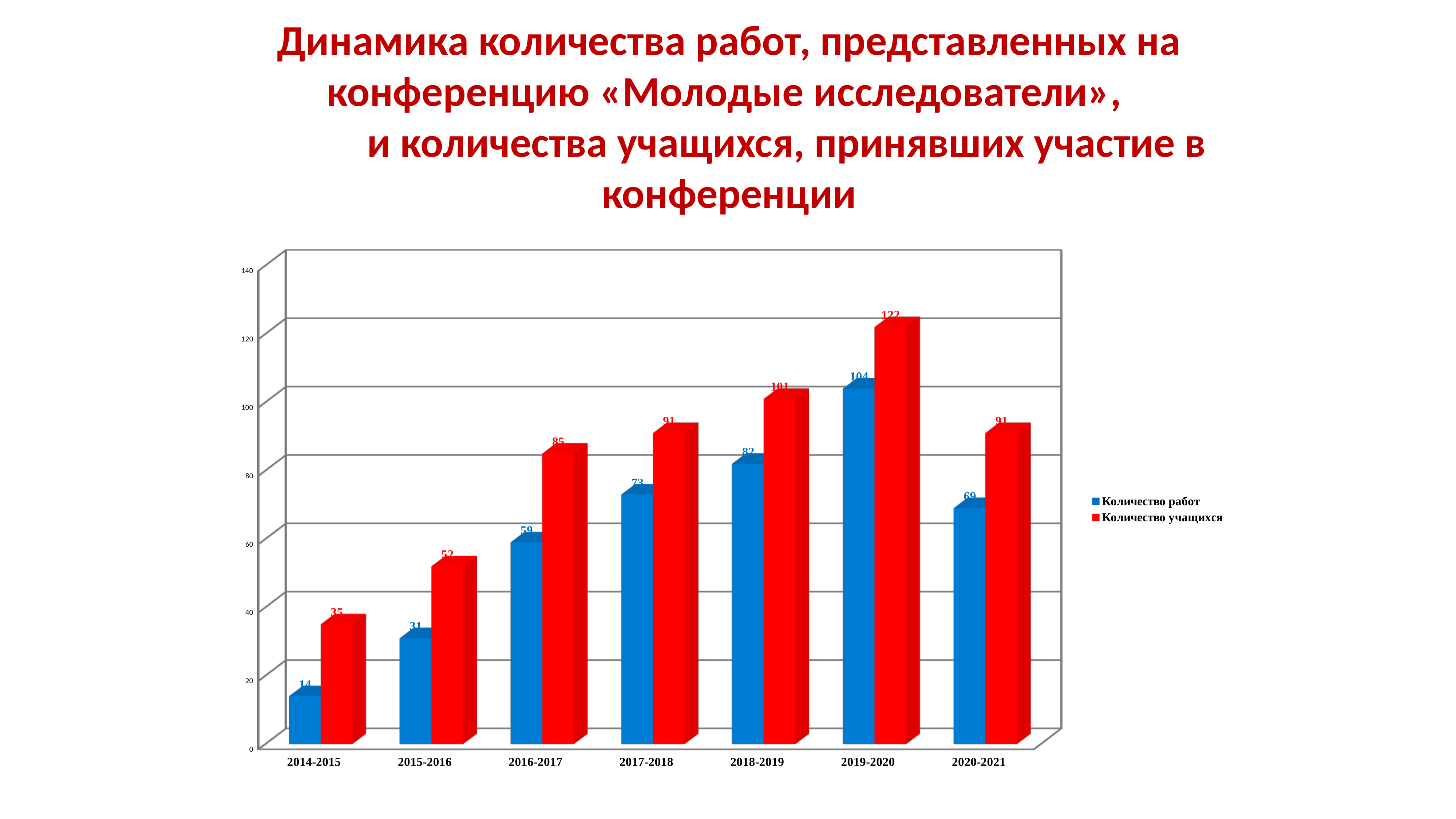
How many series does the legend list? 2 What is the value of Количество учащихся for 2019-2020? 122 What is the value of Количество работ for 2017-2018? 73 What kind of chart is shown on the slide? Bar chart What is the value of Количество учащихся for 2020-2021? 91 How many academic years are shown on the x axis? 7 Which academic year has the highest value for Количество работ? 2019-2020 Which is larger: Количество работ in 2016-2017 or Количество работ in 2020-2021? Количество работ in 2016-2017 What is the difference between Количество учащихся and Количество работ in 2018-2019? 19 What is the value of Количество работ for 2014-2015? 14 Which academic year has the lowest value for Количество учащихся? 2014-2015 Which colour represents Количество учащихся in the chart? Red